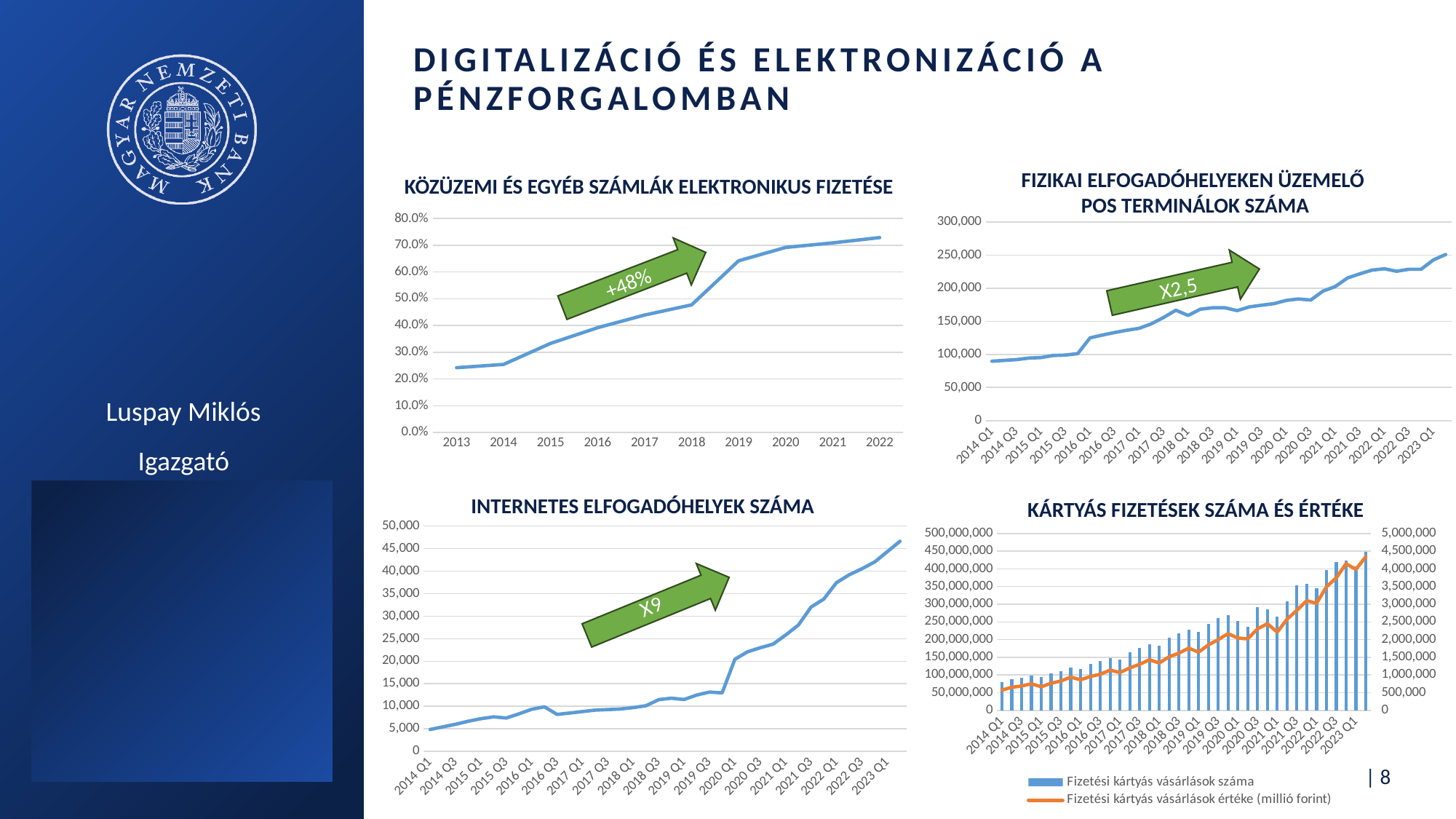
In the chart titled 'KÖZÜZEMI ÉS EGYÉB SZÁMLÁK ELEKTRONIKUS FIZETÉSE', is the value for 2013 greater or less than 30.0%? less In the chart titled 'INTERNETES ELFOGADÓHELYEK SZÁMA', is the value for 2014 Q1 greater or less than 10,000? less In the chart titled 'KÖZÜZEMI ÉS EGYÉB SZÁMLÁK ELEKTRONIKUS FIZETÉSE', is the value for 2022 greater or less than 70.0%? greater In the chart titled 'KÁRTYÁS FIZETÉSEK SZÁMA ÉS ÉRTÉKE', which series is drawn as an orange line? Fizetési kártyás vásárlások értéke (millió forint) In the chart titled 'KÖZÜZEMI ÉS EGYÉB SZÁMLÁK ELEKTRONIKUS FIZETÉSE', how many years are shown on the x axis? 10 In the chart titled 'KÖZÜZEMI ÉS EGYÉB SZÁMLÁK ELEKTRONIKUS FIZETÉSE', what kind of chart is shown? line chart In the chart titled 'KÖZÜZEMI ÉS EGYÉB SZÁMLÁK ELEKTRONIKUS FIZETÉSE', what text is written on the green arrow? +48% In the chart titled 'KÖZÜZEMI ÉS EGYÉB SZÁMLÁK ELEKTRONIKUS FIZETÉSE', do the values rise or fall from 2013 to 2022? rise In the chart titled 'KÁRTYÁS FIZETÉSEK SZÁMA ÉS ÉRTÉKE', how many series does the legend list? 2